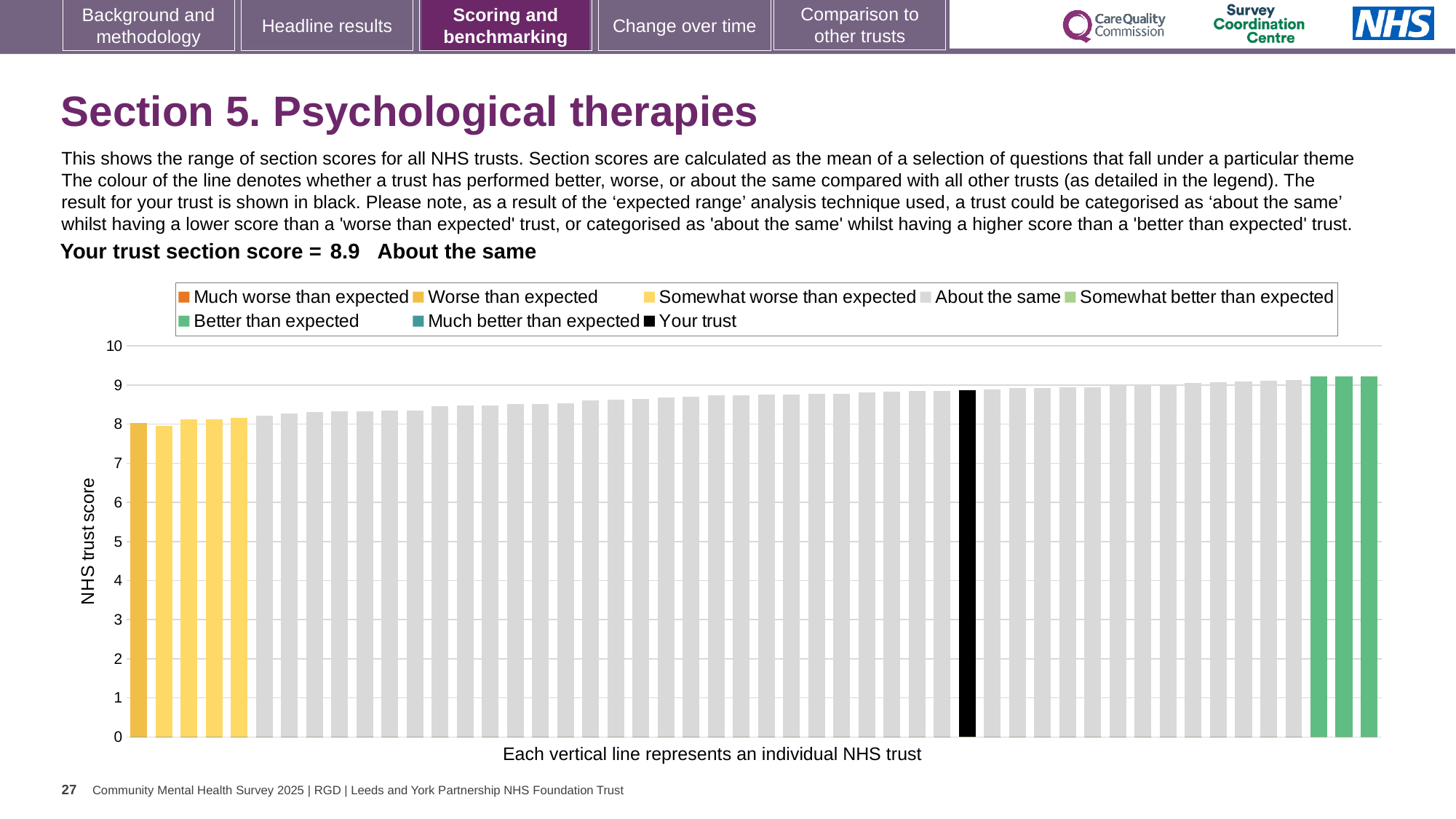
Is the value of the rightmost bar greater or less than 9? greater Is the value of the black bar (your trust) greater or less than 10? less Which category is your trust's section score placed in? About the same Which are taller, the green bars or the yellow bars? the green bars What is the label on the vertical axis of the chart? NHS trust score Do the bar values rise or fall from left to right along the x axis? rise What kind of chart is shown on the slide? bar chart How many green bars are shown in the chart? 3 What is the section score for your trust shown on the slide? 8.9 Is the value of the black bar (your trust) greater or less than 8? greater How many entries does the chart legend list? 8